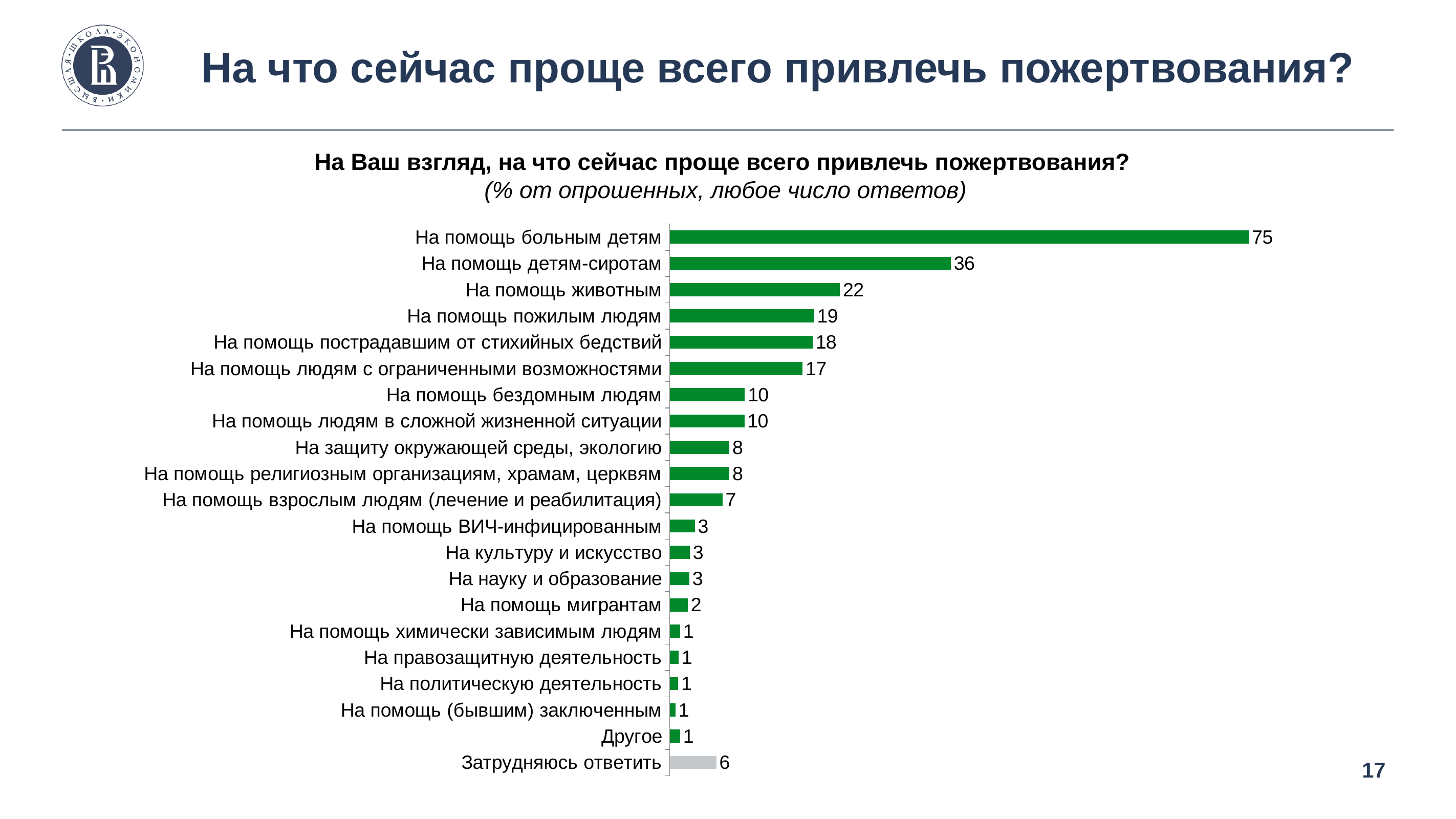
Which bar is shown in a different colour (grey) from the others? Затрудняюсь ответить What is the difference between the values for "На помощь пожилым людям" and "На помощь пострадавшим от стихийных бедствий"? 1 What is the value for "На помощь взрослым людям (лечение и реабилитация)"? 7 What is the difference between the values for "На помощь больным детям" and "На помощь детям-сиротам"? 39 What is the value for "На помощь мигрантам"? 2 What is the value for "На помощь больным детям"? 75 Which category has the highest value? На помощь больным детям What kind of chart is shown on the slide? Bar chart What is the value for "Затрудняюсь ответить"? 6 Which is larger: the value for "На помощь животным" or the value for "На помощь бездомным людям"? На помощь животным How many categories are shown in the chart? 21 What is the value for "На помощь животным"? 22